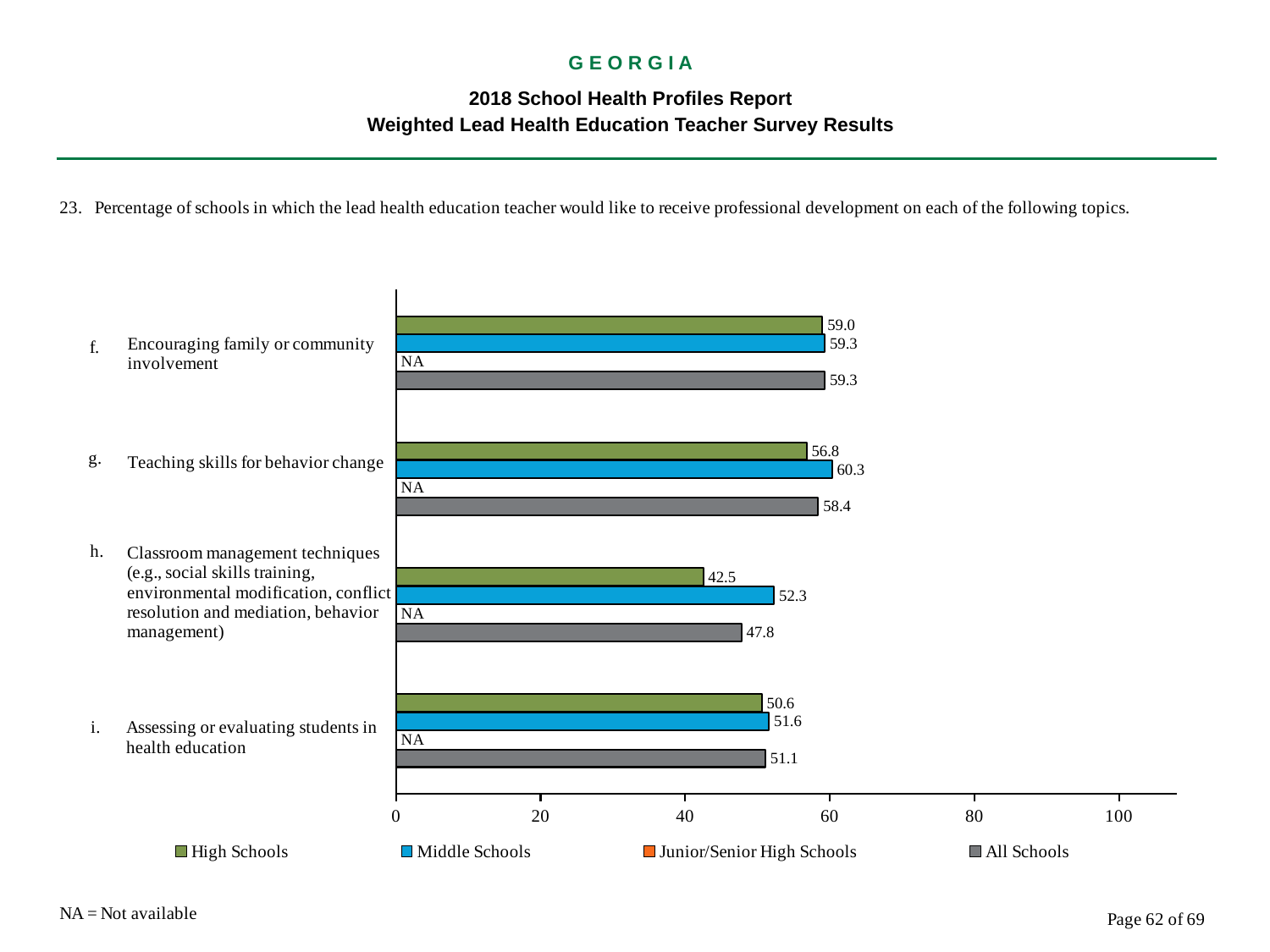
How many series does the legend list? 4 What is the value for High Schools for 'Teaching skills for behavior change'? 56.8 Which topic has the lowest High Schools value? Classroom management techniques How many topics are shown on the chart? 4 What is the difference between the Middle Schools and High Schools values for 'Classroom management techniques'? 9.8 What kind of chart is shown on the slide? bar chart What is the value for Middle Schools for 'Classroom management techniques'? 52.3 Which topic has the highest Middle Schools value? Teaching skills for behavior change What is the value for Junior/Senior High Schools for 'Encouraging family or community involvement'? NA What is the value for All Schools for 'Assessing or evaluating students in health education'? 51.1 Is the All Schools value for 'Encouraging family or community involvement' greater or less than 40? greater Which is larger for 'Teaching skills for behavior change': the High Schools value or the Middle Schools value? Middle Schools